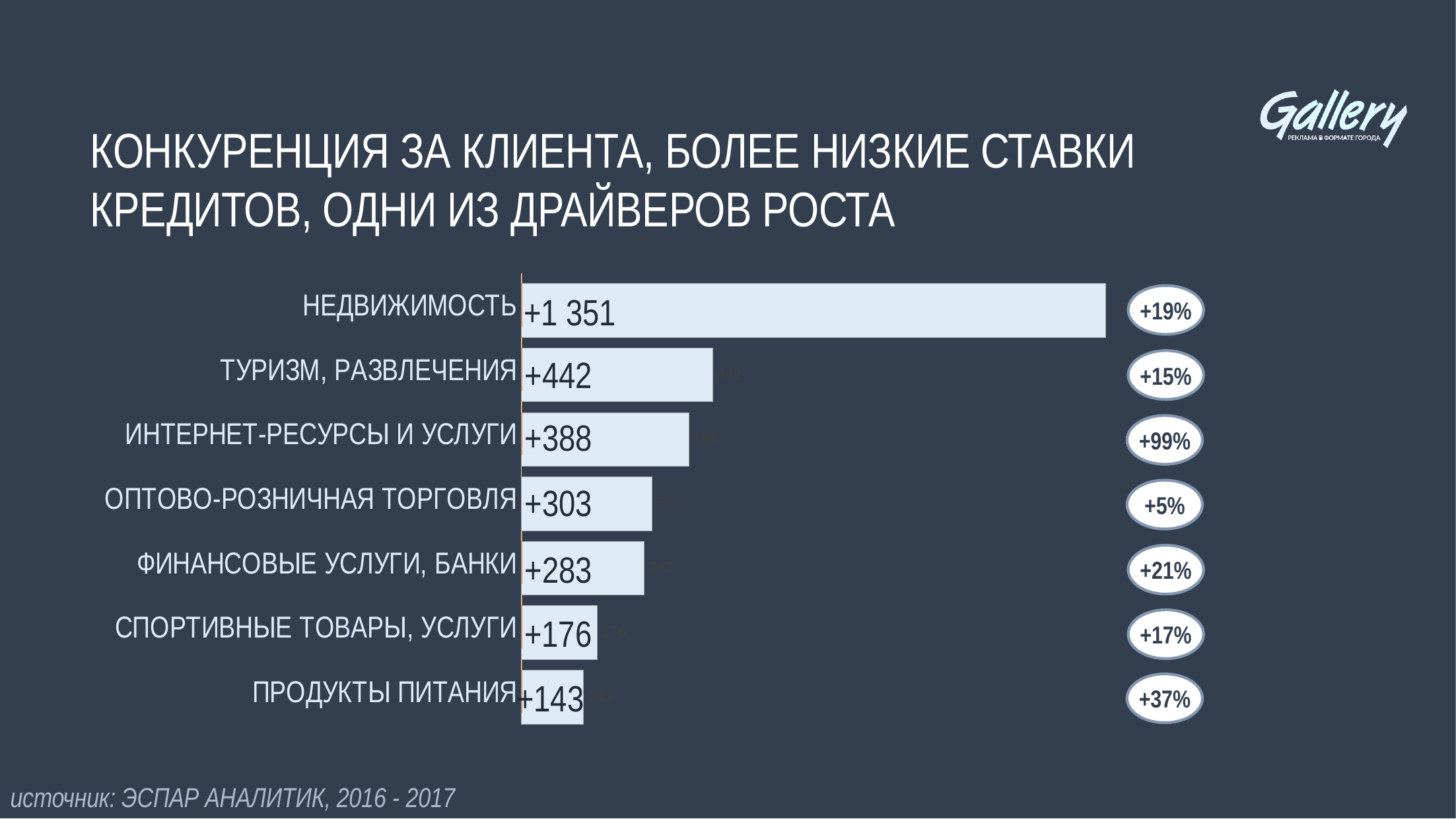
What is the value for НЕДВИЖИМОСТЬ? +1 351 What percentage is shown in the circle next to ИНТЕРНЕТ-РЕСУРСЫ И УСЛУГИ? +99% What is the difference between the values for НЕДВИЖИМОСТЬ and ТУРИЗМ, РАЗВЛЕЧЕНИЯ? 909 Which category has the lowest value? ПРОДУКТЫ ПИТАНИЯ What percentage is shown in the circle next to ПРОДУКТЫ ПИТАНИЯ? +37% Which category has the highest value? НЕДВИЖИМОСТЬ Which is larger, the value for ТУРИЗМ, РАЗВЛЕЧЕНИЯ or the value for СПОРТИВНЫЕ ТОВАРЫ, УСЛУГИ? ТУРИЗМ, РАЗВЛЕЧЕНИЯ What kind of chart is shown on the slide? bar chart What is the difference between the values for ОПТОВО-РОЗНИЧНАЯ ТОРГОВЛЯ and ФИНАНСОВЫЕ УСЛУГИ, БАНКИ? 20 What is the value for ФИНАНСОВЫЕ УСЛУГИ, БАНКИ? +283 What is the value for ИНТЕРНЕТ-РЕСУРСЫ И УСЛУГИ? +388 How many categories are shown in the chart? 7